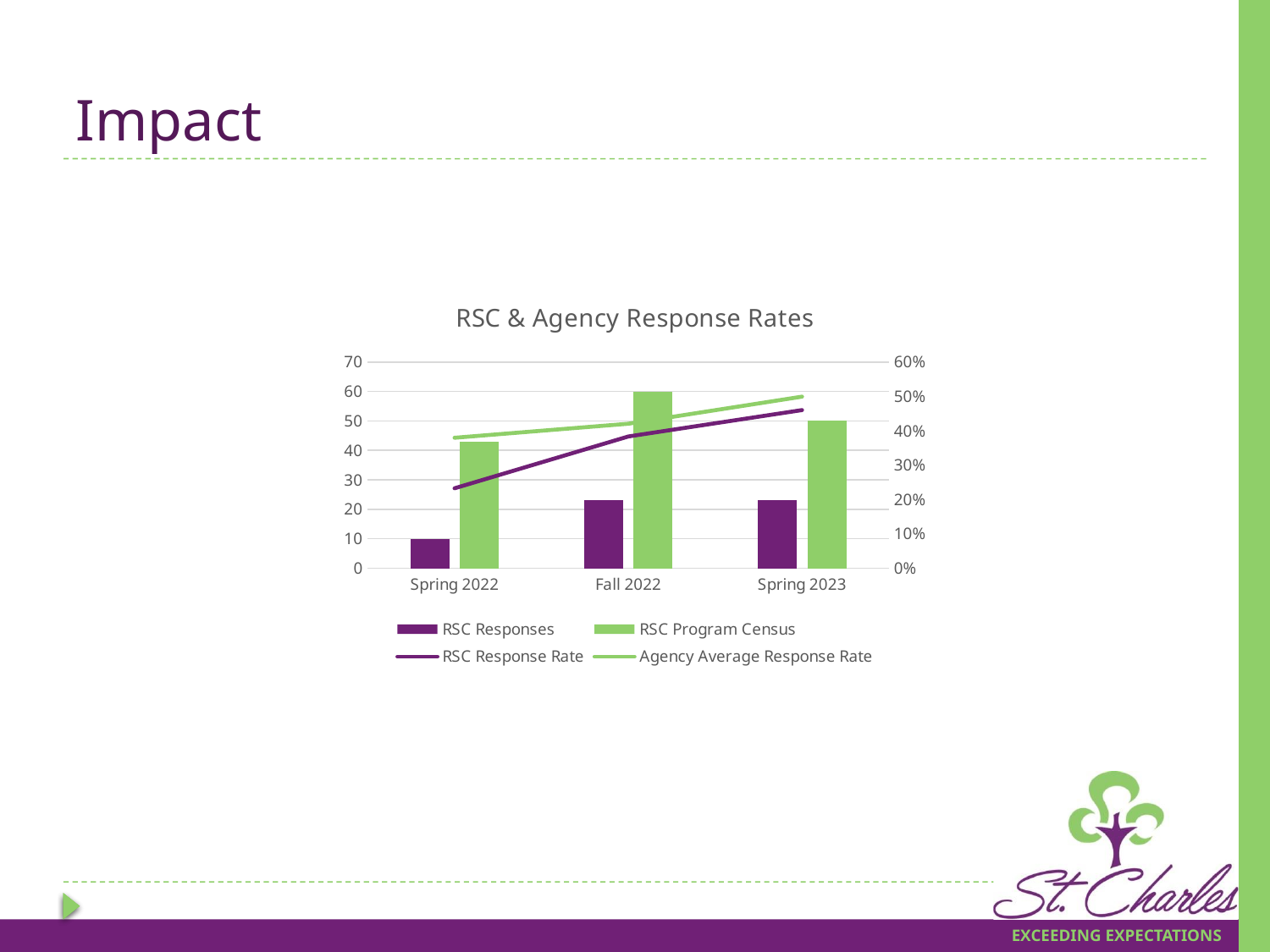
In Spring 2022, which is higher: the RSC Response Rate or the Agency Average Response Rate? Agency Average Response Rate How many series does the legend of the 'RSC & Agency Response Rates' chart list? 4 In which period is the RSC Program Census bar highest? Fall 2022 What is the title of the chart on the slide? RSC & Agency Response Rates Is the RSC Program Census value for Spring 2022 greater or less than 40? greater In which period is the RSC Responses bar lowest? Spring 2022 Does the RSC Response Rate line rise or fall from Spring 2022 to Spring 2023? It rises What is the RSC Program Census value for Fall 2022? 60 How many categories are shown on the x axis of the chart? 3 Is the RSC Responses value for Fall 2022 greater or less than 20? greater Is the RSC Response Rate for Spring 2022 greater or less than 30%? less What kind of chart is shown on the slide? A combination bar and line chart